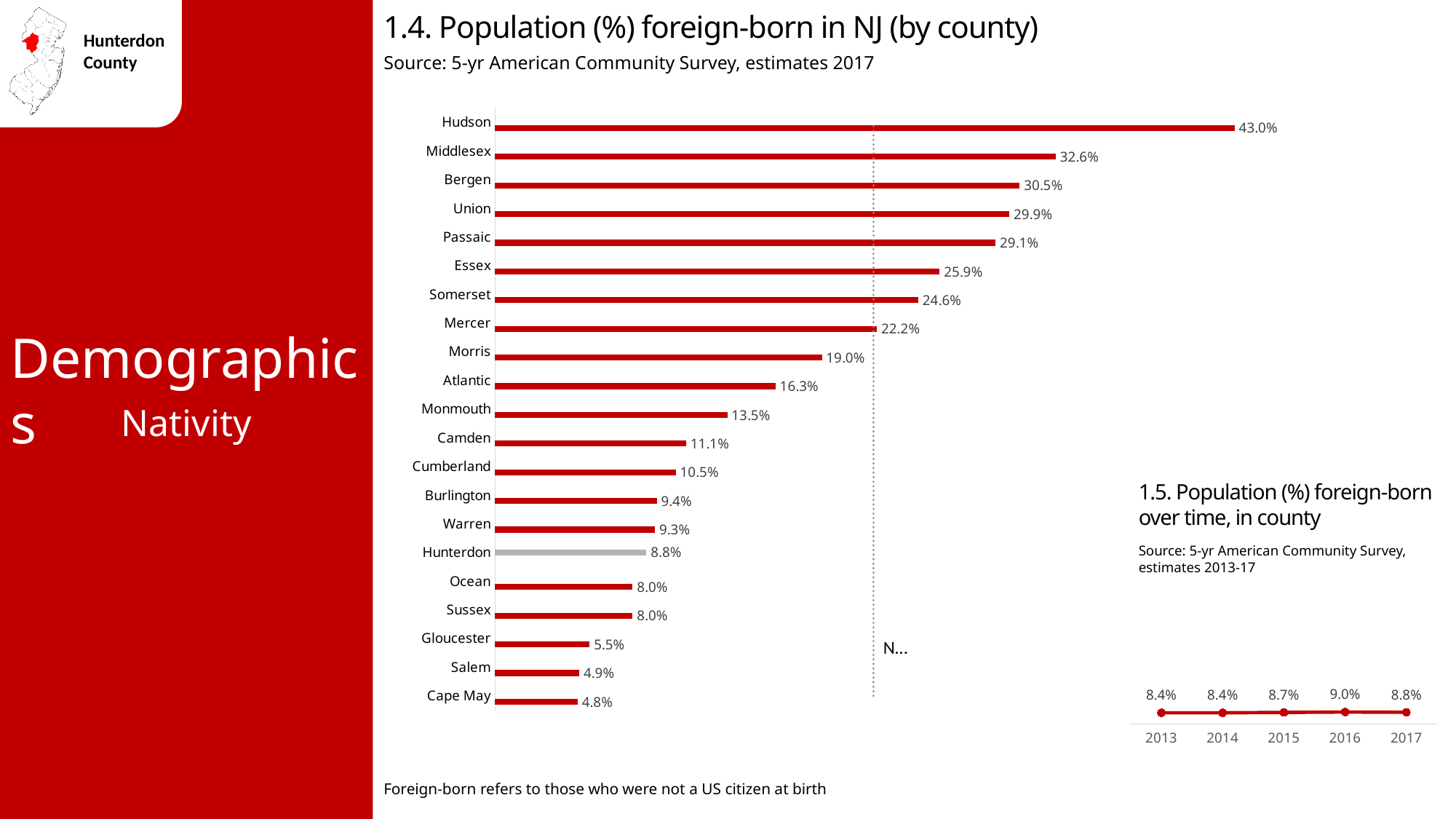
In the chart '1.4. Population (%) foreign-born in NJ (by county)', what is the difference between Hudson and Middlesex? 10.4% In the chart '1.4. Population (%) foreign-born in NJ (by county)', which bar is coloured grey instead of red? Hunterdon In the chart '1.5. Population (%) foreign-born over time, in county', what is the difference between the 2017 and 2013 values? 0.4% In the chart '1.5. Population (%) foreign-born over time, in county', how many years are plotted? 5 What kind of chart is '1.4. Population (%) foreign-born in NJ (by county)'? bar chart In the chart '1.5. Population (%) foreign-born over time, in county', what is the value for 2016? 9.0% In the chart '1.4. Population (%) foreign-born in NJ (by county)', what is the value for Hunterdon? 8.8% In the chart '1.4. Population (%) foreign-born in NJ (by county)', which county has the highest value? Hudson In the chart '1.4. Population (%) foreign-born in NJ (by county)', which county has the lowest value? Cape May In the chart '1.4. Population (%) foreign-born in NJ (by county)', how many counties are shown? 21 In the chart '1.4. Population (%) foreign-born in NJ (by county)', which is larger, Bergen or Union? Bergen In the chart '1.4. Population (%) foreign-born in NJ (by county)', what is the value for Mercer? 22.2%